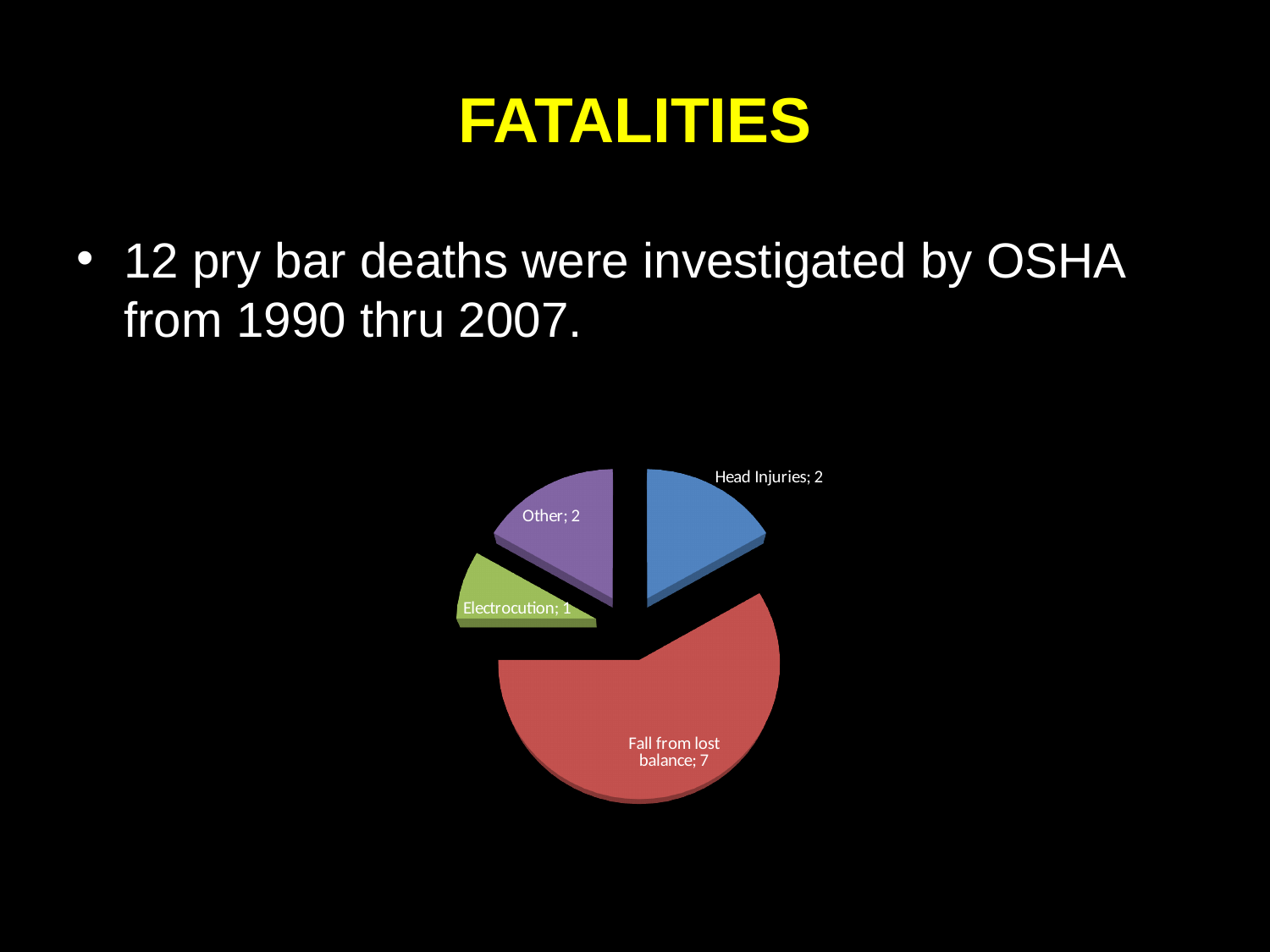
Which is larger, the value for Head Injuries or the value for Electrocution? Head Injuries Which category has the smallest slice of the pie? Electrocution What colour is the Fall from lost balance slice? red How many categories does the pie chart show? 4 How many fatalities are attributed to Head Injuries? 2 How many fatalities are in the Other category? 2 How many fatalities are attributed to Fall from lost balance? 7 What kind of chart is shown on the slide? pie chart How many fatalities are attributed to Electrocution? 1 Which category has the largest slice of the pie? Fall from lost balance What is the total of all the slices in the pie chart? 12 What is the difference between the Fall from lost balance value and the Head Injuries value? 5